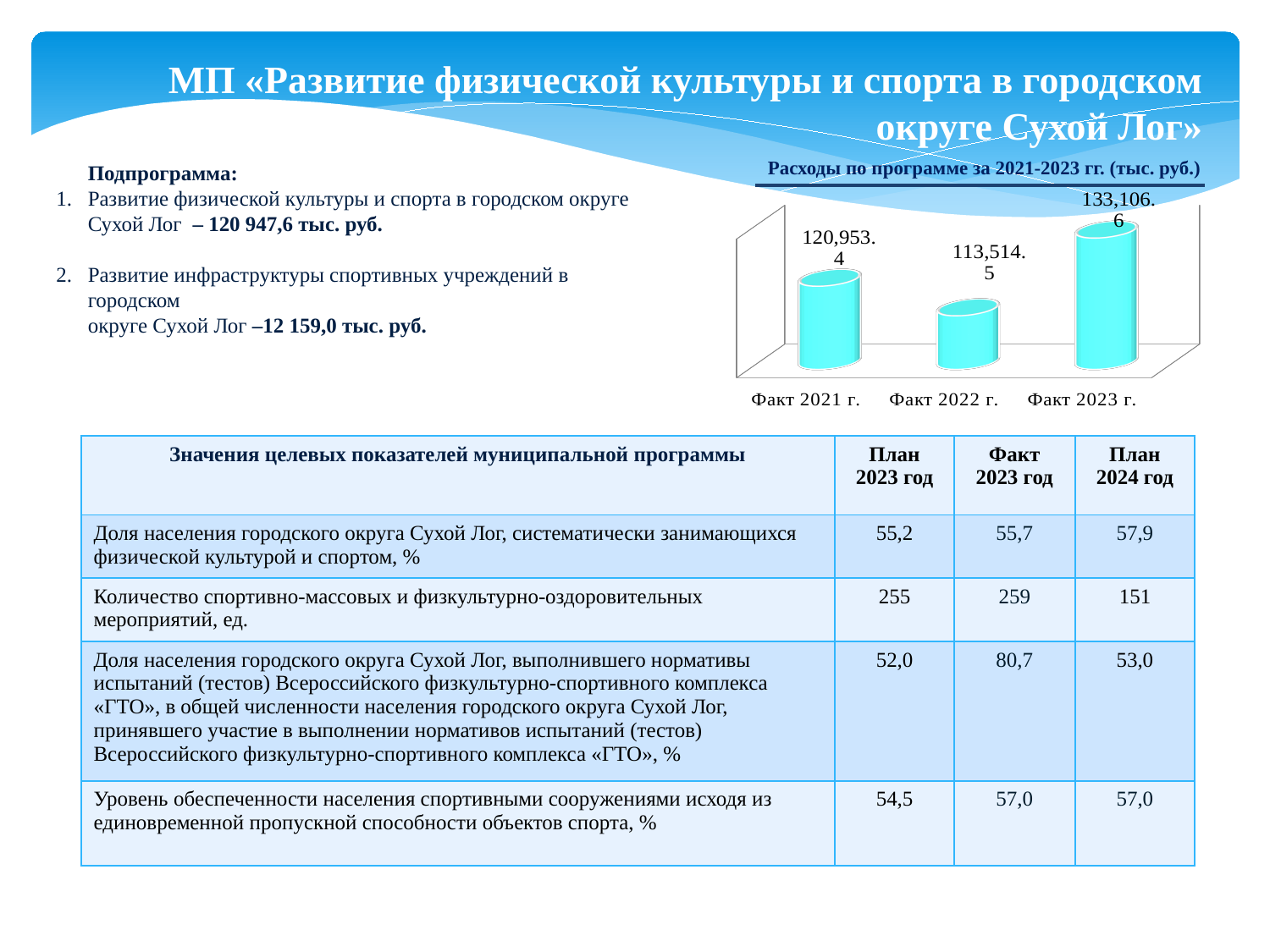
Which is larger in the chart, the value for Факт 2021 г. or Факт 2022 г.? Факт 2021 г. How many categories are plotted in the chart? 3 What is the title of the chart on the slide? Расходы по программе за 2021-2023 гг. (тыс. руб.) What is the difference between the values for Факт 2021 г. and Факт 2022 г. in the chart? 7,438.9 What is the value for Факт 2022 г. in the chart? 113,514.5 Which category has the lowest value in the chart? Факт 2022 г. What type of chart is shown on the slide? bar chart What is the value for Факт 2023 г. in the chart? 133,106.6 What is the value for Факт 2021 г. in the chart? 120,953.4 Which category has the highest value in the chart? Факт 2023 г. Does the value rise or fall from Факт 2022 г. to Факт 2023 г. in the chart? rise What is the difference between the values for Факт 2023 г. and Факт 2021 г. in the chart? 12,153.2